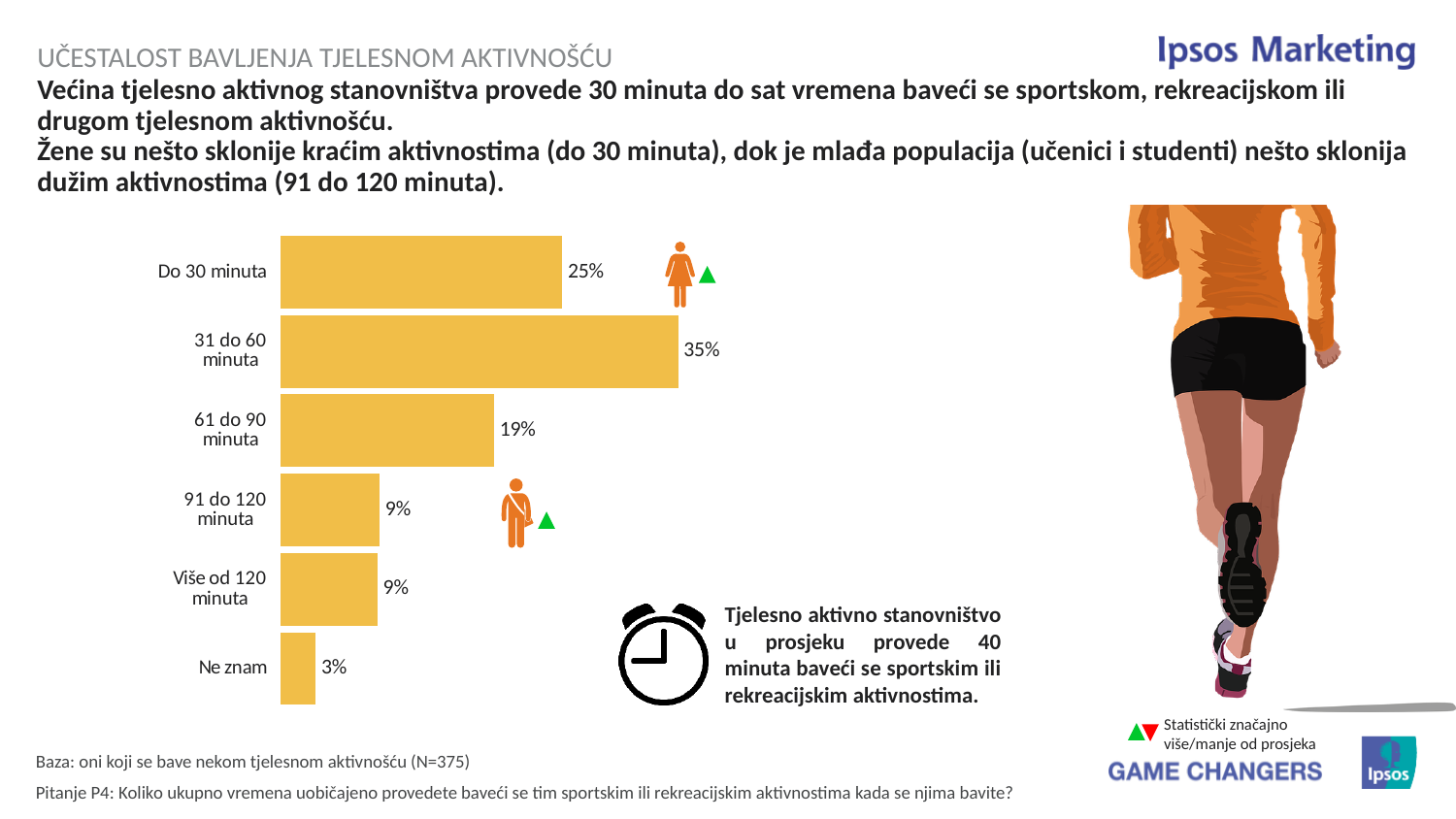
Which category has the highest value? 31 do 60 minuta How many categories are shown in the chart? 6 What is the value for the '31 do 60 minuta' category? 35% Which category has the lowest value? Ne znam What is the difference between the values for '61 do 90 minuta' and '91 do 120 minuta'? 10% What is the value for the 'Do 30 minuta' category? 25% What kind of chart is shown on the slide? Bar chart What is the difference between the values for '31 do 60 minuta' and 'Do 30 minuta'? 10% Which is larger, the value for 'Do 30 minuta' or the value for '61 do 90 minuta'? Do 30 minuta What is the value for the '61 do 90 minuta' category? 19% What is the value for the 'Ne znam' category? 3% What colour are the bars in the chart? Yellow